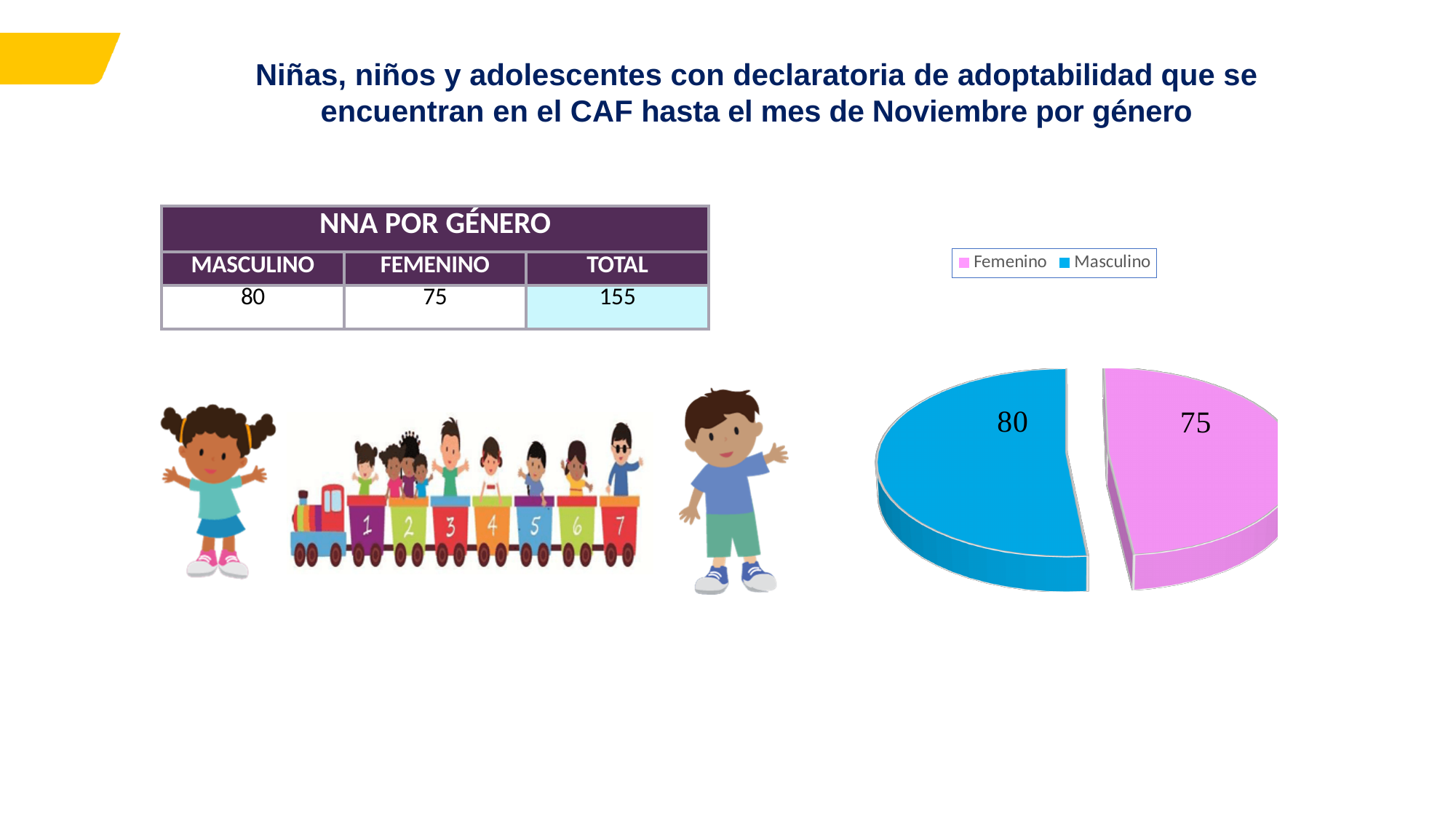
Which is larger in the pie chart, Masculino or Femenino? Masculino Which slice of the pie chart is the smallest? Femenino What is the total of the two slices in the pie chart? 155 Which slice of the pie chart is the largest? Masculino What is the difference between the Masculino and Femenino values in the pie chart? 5 What value is shown for the Femenino slice of the pie chart? 75 How many entries does the pie chart legend list? 2 What colour is the Femenino slice in the pie chart? Pink How many slices does the pie chart have? 2 What value is shown for the Masculino slice of the pie chart? 80 What kind of chart is shown on the slide? Pie chart What colour is the Masculino slice in the pie chart? Blue